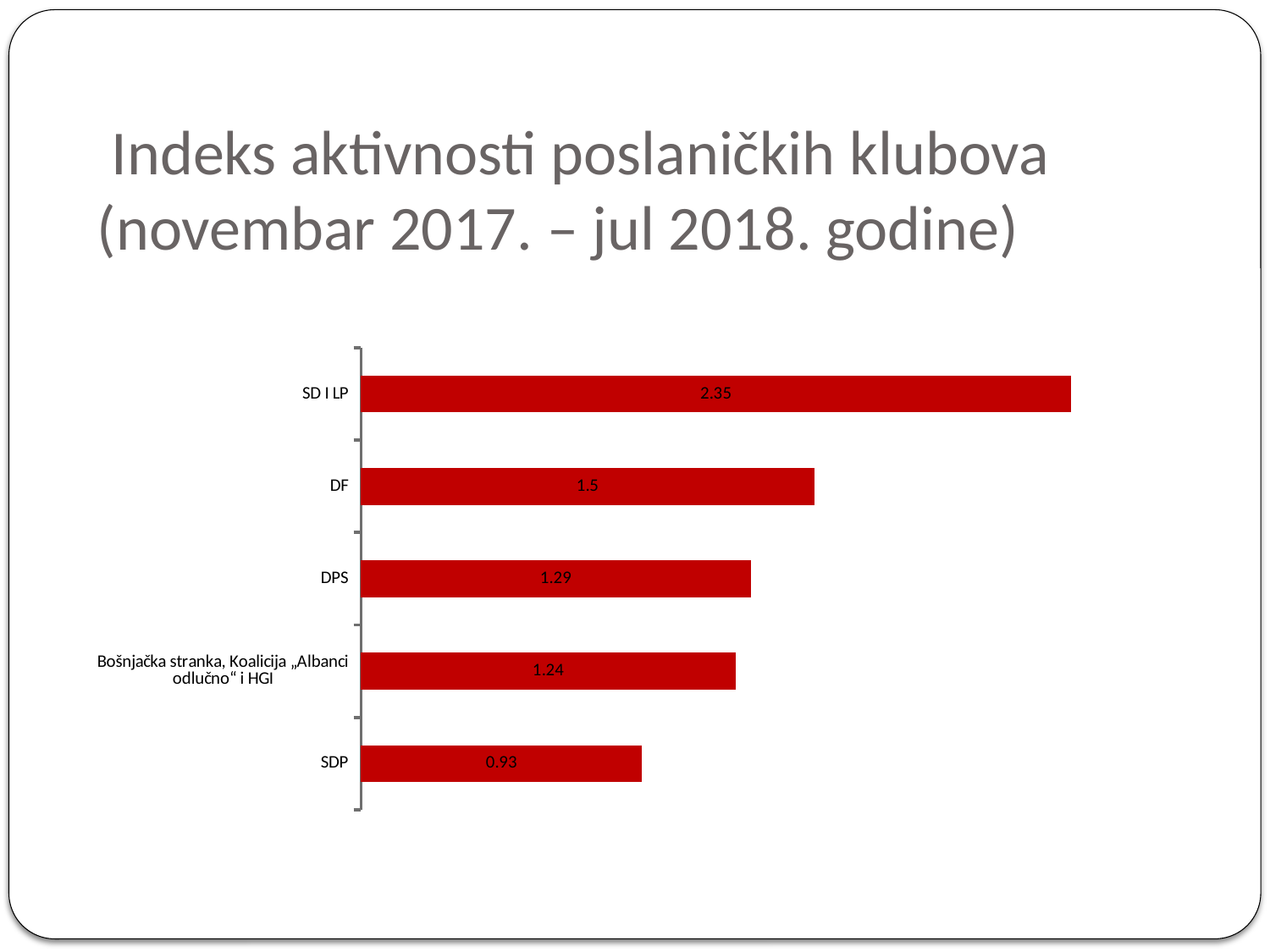
What type of chart is shown on the slide? Bar chart What is the activity index value for DPS? 1.29 Which parliamentary club has the highest activity index? SD I LP What is the difference between the activity index of SD I LP and DF? 0.85 Which has a higher activity index, DF or DPS? DF What is the activity index value for DF? 1.5 What is the difference between the activity index of DPS and SDP? 0.36 What is the activity index value for Bošnjačka stranka, Koalicija „Albanci odlučno“ i HGI? 1.24 What is the activity index value for SD I LP? 2.35 How many parliamentary clubs are shown in the chart? 5 What is the activity index value for SDP? 0.93 Which parliamentary club has the lowest activity index? SDP